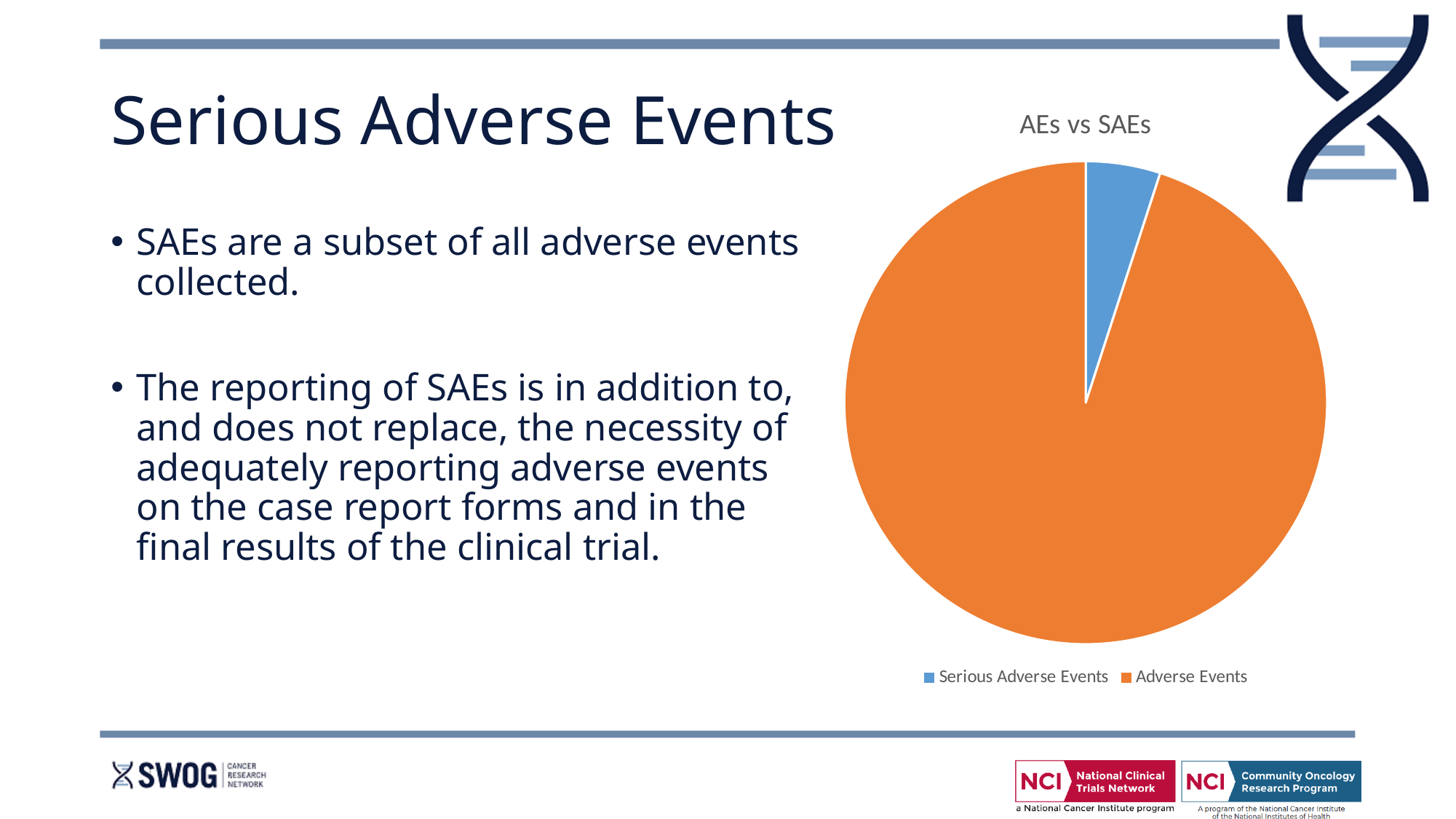
How many slices does the pie chart have? 2 What is the title of the chart? AEs vs SAEs Which slice of the pie chart is the largest? Adverse Events Which is larger in the pie chart, Serious Adverse Events or Adverse Events? Adverse Events How many entries does the chart legend list? 2 What kind of chart is shown on the slide? pie chart What colour is the Serious Adverse Events slice? blue Which slice of the pie chart is the smallest? Serious Adverse Events